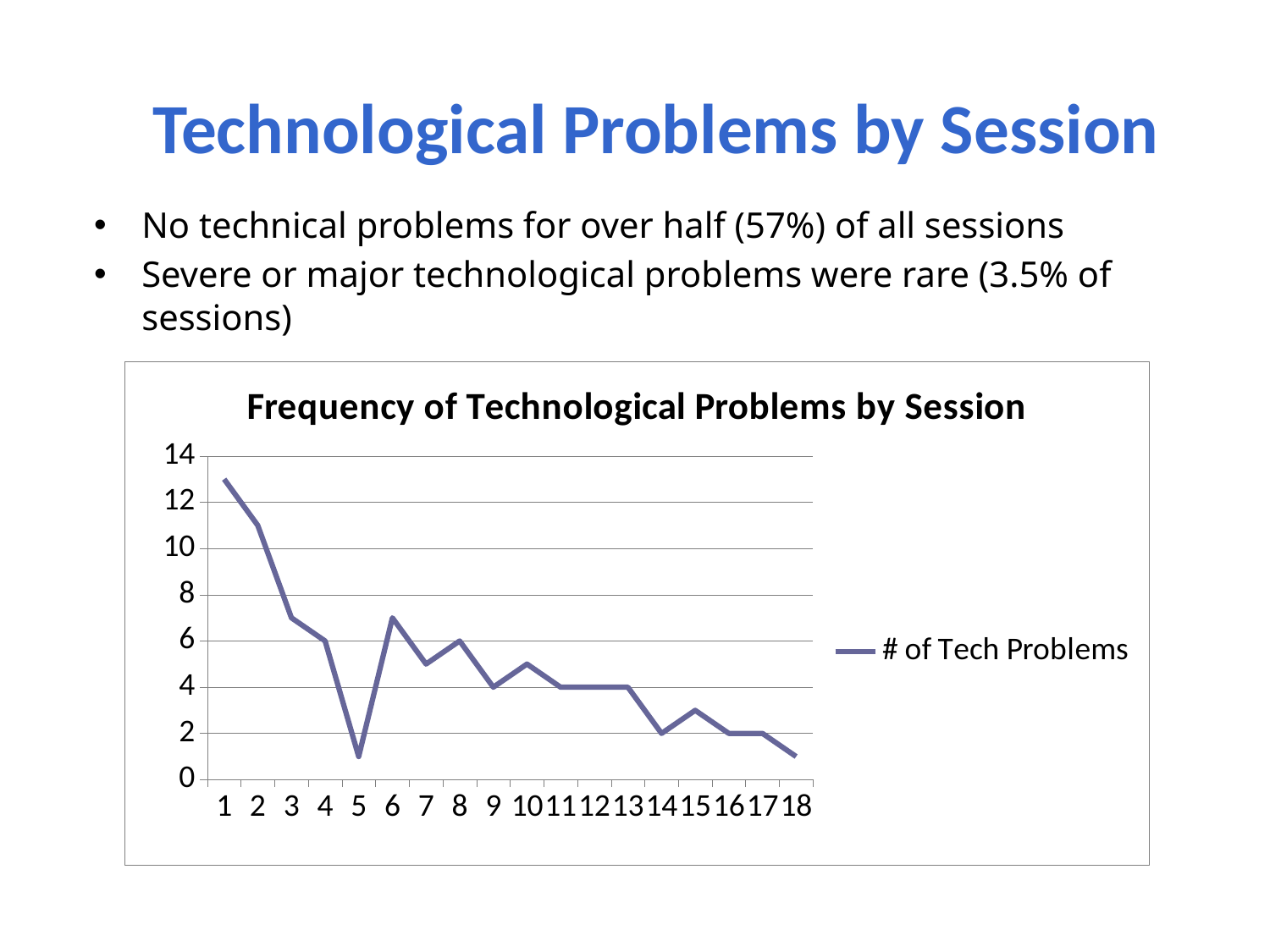
What is the title of the chart? Frequency of Technological Problems by Session What is the name of the series shown in the legend? # of Tech Problems Which has more tech problems, session 6 or session 14? session 6 Which has more tech problems, session 1 or session 18? session 1 Which session has the highest number of tech problems? 1 Is the value for session 5 greater or less than 2? less Is the value for session 1 greater or less than 12? greater Is the value for session 3 greater or less than 8? less Overall, do the values rise or fall from session 1 to session 18? fall How many series does the legend list? 1 What kind of chart is shown on the slide? line chart How many sessions are plotted along the x axis? 18